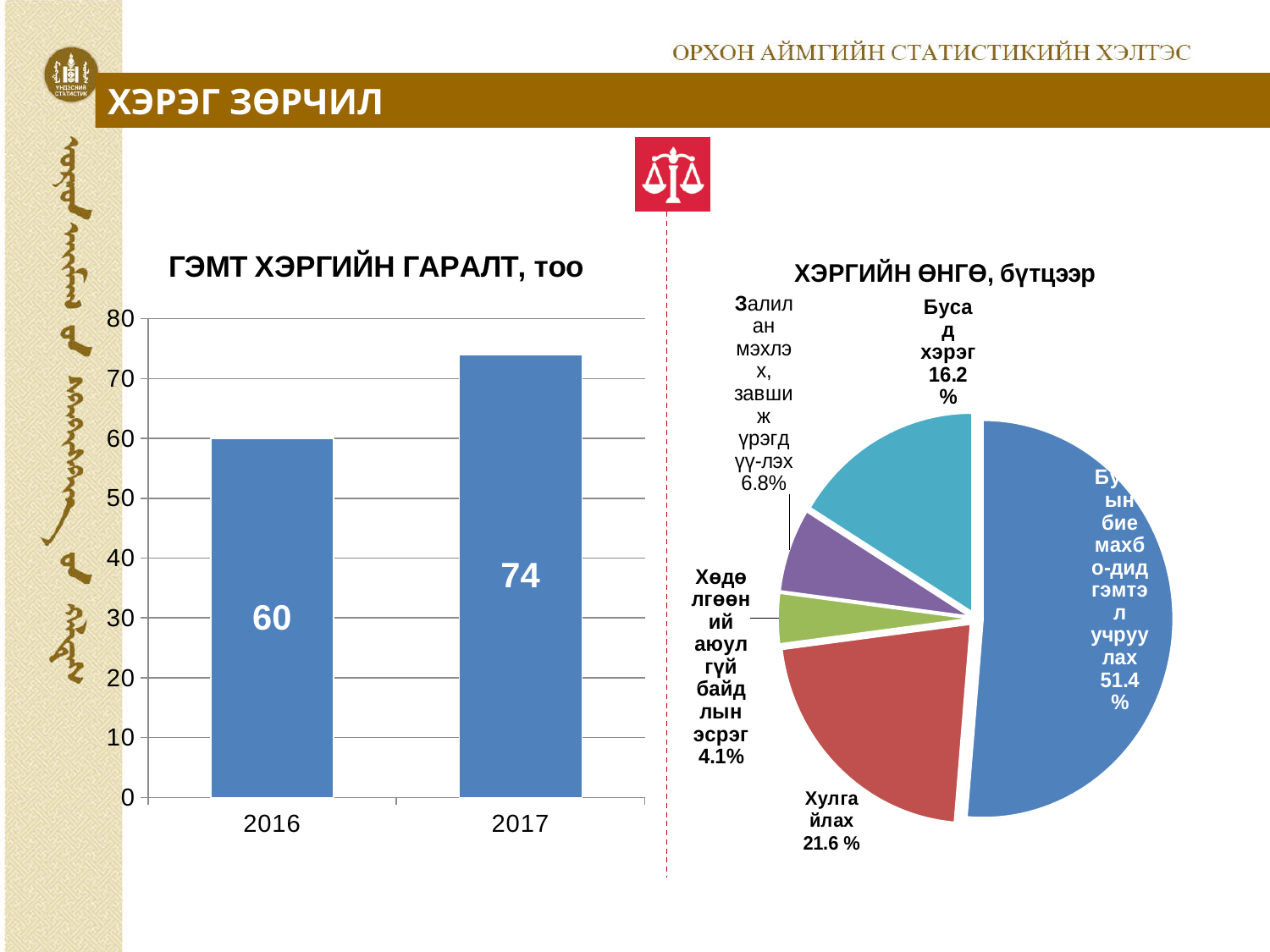
In the bar chart titled ГЭМТ ХЭРГИЙН ГАРАЛТ, тоо, what is the value for 2017? 74 In the bar chart titled ГЭМТ ХЭРГИЙН ГАРАЛТ, тоо, by how much does the 2017 value exceed the 2016 value? 14 In the pie chart titled ХЭРГИЙН ӨНГӨ, бүтцээр, which is larger: Залилан мэхлэх, завшиж үрэгдүүлэх or Хөдөлгөөний аюулгүй байдлын эсрэг? Залилан мэхлэх, завшиж үрэгдүүлэх In the pie chart titled ХЭРГИЙН ӨНГӨ, бүтцээр, what share does Хулгайлах have? 21.6 % In the pie chart titled ХЭРГИЙН ӨНГӨ, бүтцээр, what share does Бусад хэрэг have? 16.2% In the pie chart titled ХЭРГИЙН ӨНГӨ, бүтцээр, which slice is the smallest? Хөдөлгөөний аюулгүй байдлын эсрэг How many bars are shown in the bar chart titled ГЭМТ ХЭРГИЙН ГАРАЛТ, тоо? 2 In the bar chart titled ГЭМТ ХЭРГИЙН ГАРАЛТ, тоо, do the values rise or fall from 2016 to 2017? rise What type of chart is the left chart titled ГЭМТ ХЭРГИЙН ГАРАЛТ, тоо? bar chart In the bar chart titled ГЭМТ ХЭРГИЙН ГАРАЛТ, тоо, which year has the higher value? 2017 What type of chart is the right chart titled ХЭРГИЙН ӨНГӨ, бүтцээр? pie chart In the bar chart titled ГЭМТ ХЭРГИЙН ГАРАЛТ, тоо, what is the value for 2016? 60